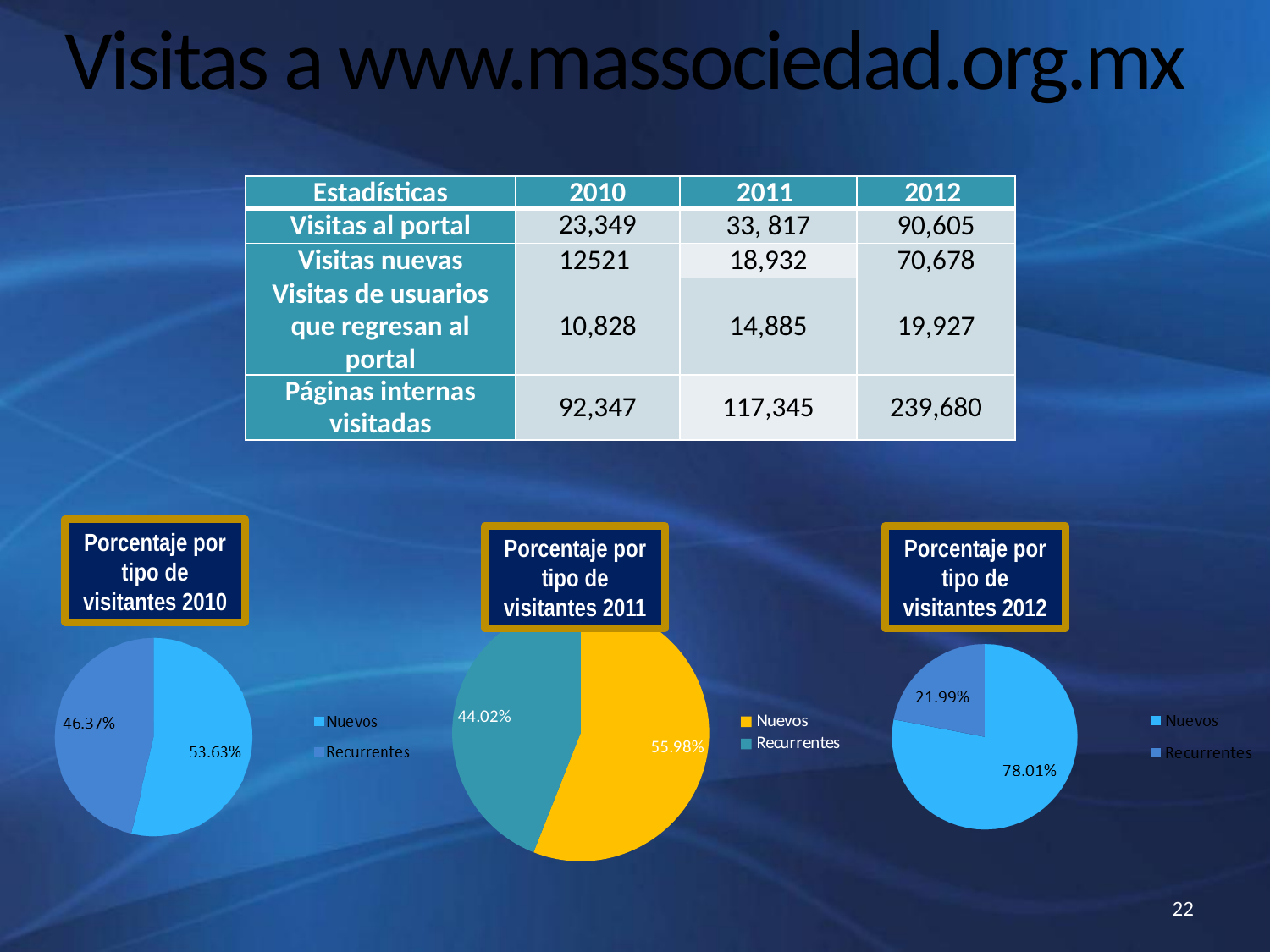
In the 'Porcentaje por tipo de visitantes 2012' chart, what share of visitors is Recurrentes? 21.99% In the 'Porcentaje por tipo de visitantes 2012' chart, what share of visitors is Nuevos? 78.01% In the 'Porcentaje por tipo de visitantes 2011' chart, what share of visitors is Nuevos? 55.98% What kind of chart is 'Porcentaje por tipo de visitantes 2011'? Pie chart How many series does the legend of the 'Porcentaje por tipo de visitantes 2012' chart list? 2 In the 'Porcentaje por tipo de visitantes 2011' chart, which category has the smallest slice? Recurrentes In the 'Porcentaje por tipo de visitantes 2012' chart, what is the difference between the Nuevos and Recurrentes shares? 56.02% In the 'Porcentaje por tipo de visitantes 2010' chart, what share of visitors is Nuevos? 53.63% In the 'Porcentaje por tipo de visitantes 2010' chart, what share of visitors is Recurrentes? 46.37% In the 'Porcentaje por tipo de visitantes 2010' chart, which is larger, Nuevos or Recurrentes? Nuevos In the 'Porcentaje por tipo de visitantes 2011' chart, what share of visitors is Recurrentes? 44.02% In the 'Porcentaje por tipo de visitantes 2012' chart, which category has the largest slice? Nuevos